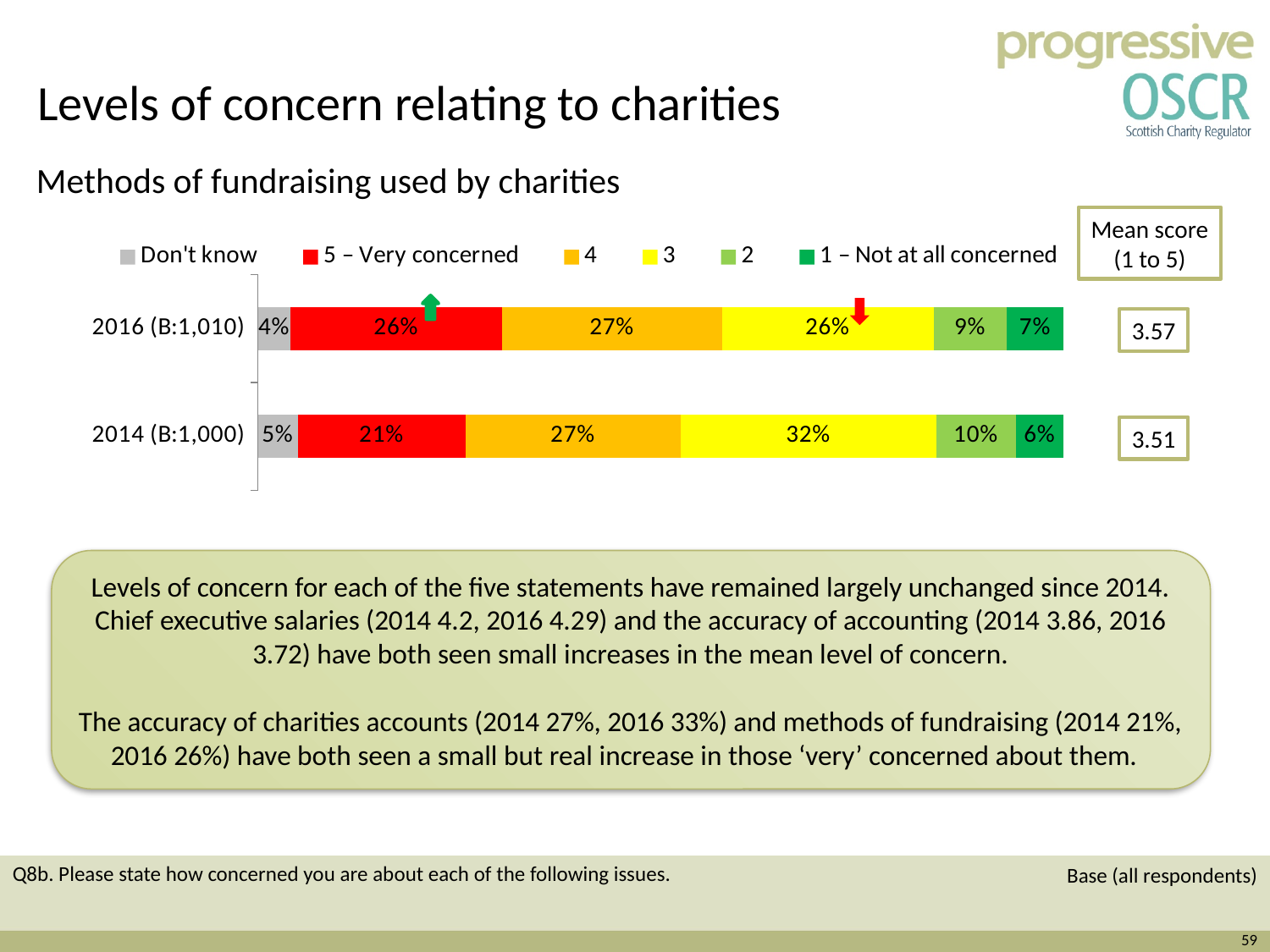
By how many percentage points did the '5 – Very concerned' share change from 2014 (B:1,000) to 2016 (B:1,010)? 5 percentage points Which year has the larger share of respondents rating 3: 2014 (B:1,000) or 2016 (B:1,010)? 2014 (B:1,000) What percentage of respondents in 2014 (B:1,000) gave a rating of 3? 32% How many categories (years) are plotted on the chart? 2 What is the mean score (1 to 5) shown for 2016 (B:1,010)? 3.57 What percentage of respondents in 2016 (B:1,010) were '1 – Not at all concerned'? 7% What percentage of respondents in 2016 (B:1,010) were '5 – Very concerned'? 26% Which series is shown in red in the legend? 5 – Very concerned What type of chart is shown on the slide? Stacked bar chart How many series does the legend list? 6 Which year has the larger share of respondents rating 2: 2014 (B:1,000) or 2016 (B:1,010)? 2014 (B:1,000) What is the 'Don't know' value for 2014 (B:1,000)? 5%